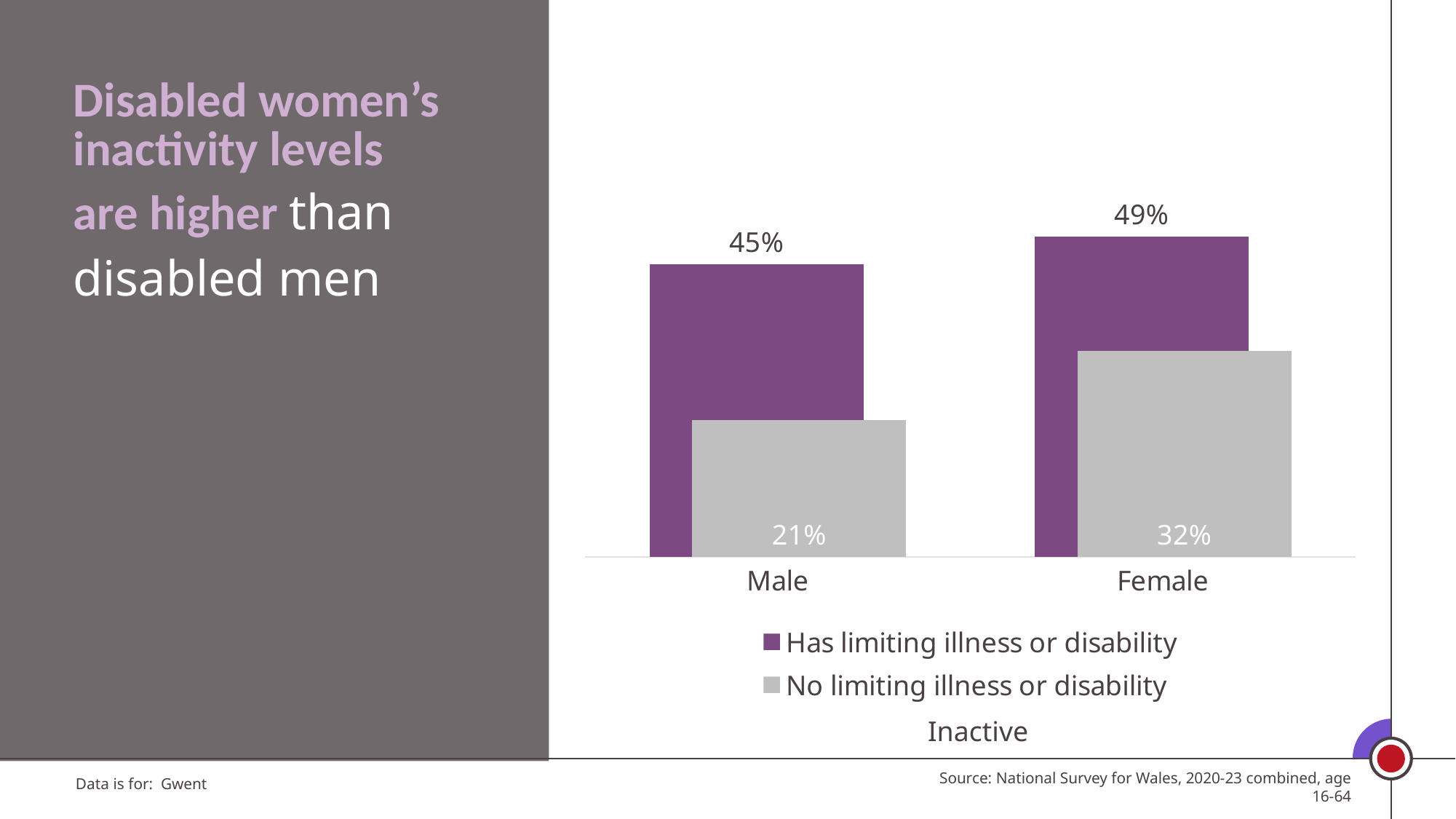
What is the inactivity value for Female with no limiting illness or disability? 32% What is the inactivity value for Male with a limiting illness or disability? 45% How many categories are shown on the x axis? 2 What is the inactivity value for Female with a limiting illness or disability? 49% What is the difference between the Female and Male values for 'Has limiting illness or disability'? 4% Which is larger: the Female value for 'No limiting illness or disability' or the Male value for 'No limiting illness or disability'? Female How many series does the legend list? 2 What kind of chart is shown on the slide? Bar chart Which category has the lowest value in the 'No limiting illness or disability' series? Male Which category has the highest value in the 'Has limiting illness or disability' series? Female What is the inactivity value for Male with no limiting illness or disability? 21% What is the difference between the 'Has limiting illness or disability' and 'No limiting illness or disability' values for Male? 24%